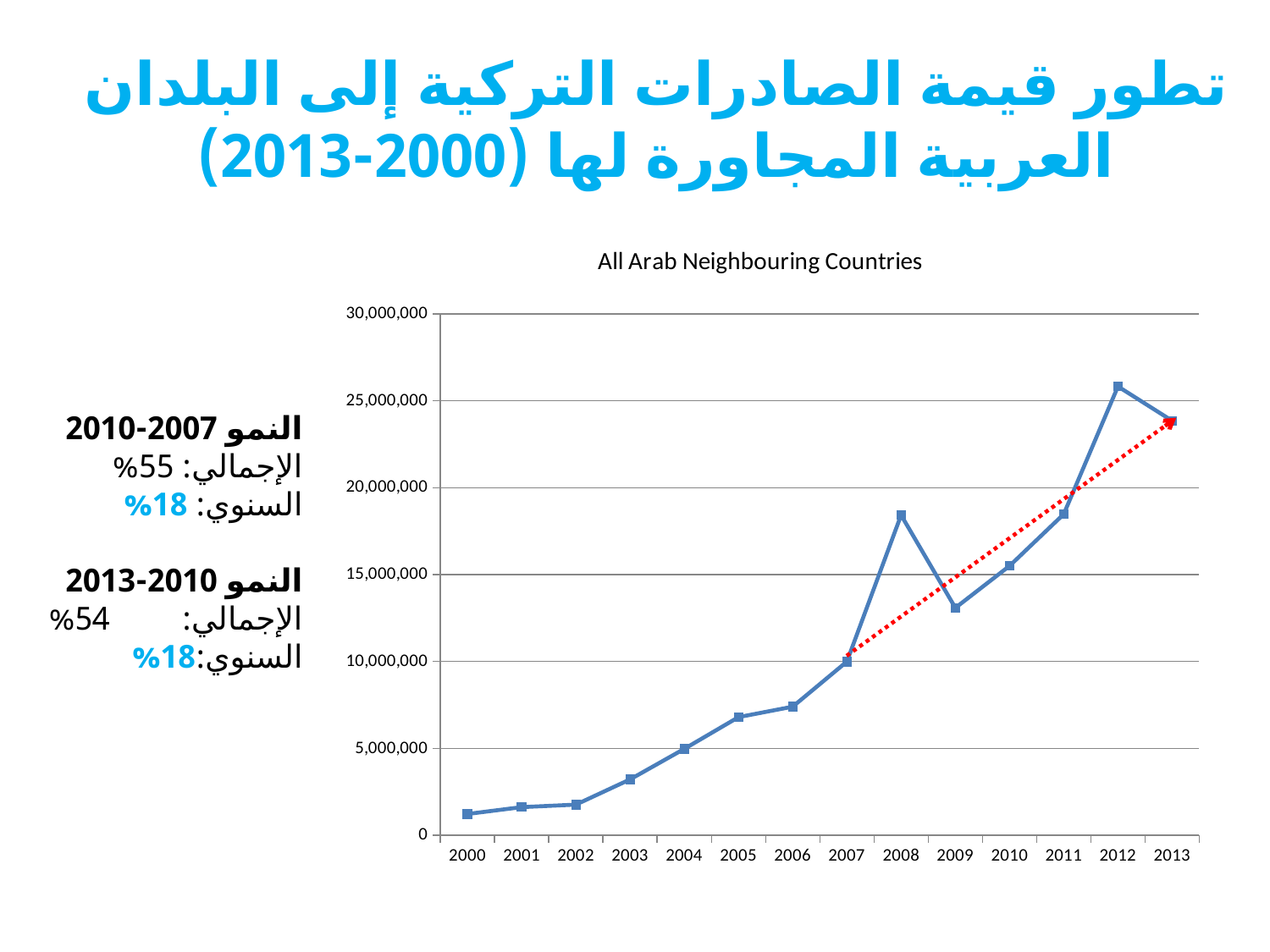
Is the value for 2003 greater or less than 5,000,000? less Which year has the lowest value in the chart? 2000 Is the value for 2008 greater or less than 15,000,000? greater Overall, do the values rise or fall from 2000 to 2013? rise Is the value for 2012 greater or less than 25,000,000? greater How many years are plotted on the x axis of the chart? 14 What type of chart is shown on the slide? line chart Which year has the larger value, 2012 or 2013? 2012 Which year has the larger value, 2008 or 2009? 2008 What is the title of the chart? All Arab Neighbouring Countries Which year has the highest value in the chart? 2012